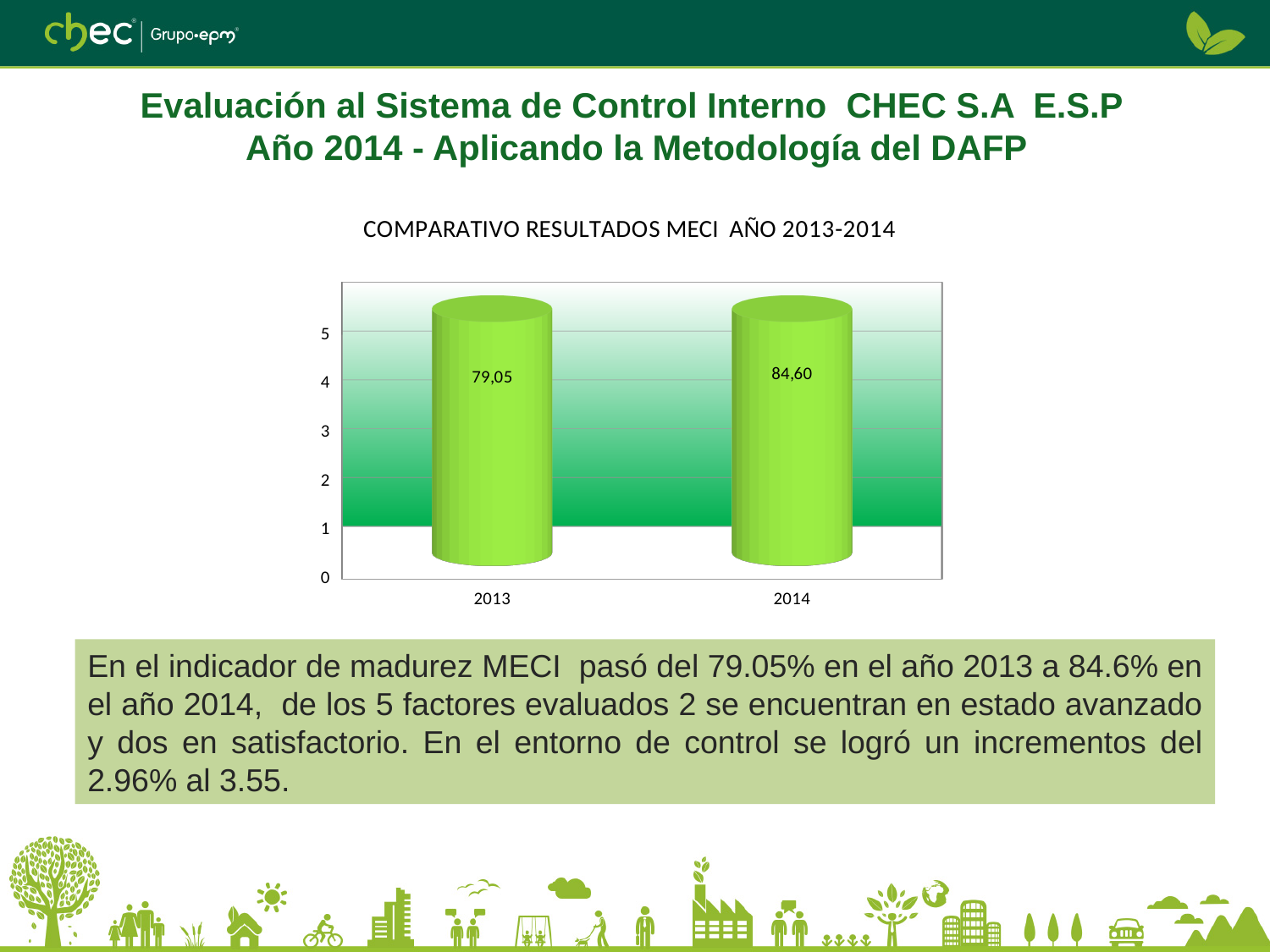
Do the labelled values rise or fall from 2013 to 2014? rise By how much does the labelled value for 2014 exceed the value for 2013? 5,55 Is the labelled value for 2014 larger or smaller than the value for 2013? larger Which year has the higher labelled value in the chart? 2014 What is the highest tick value shown on the chart's vertical axis? 5 What is the title of the chart on the slide? COMPARATIVO RESULTADOS MECI AÑO 2013-2014 What value is shown for 2014 in the COMPARATIVO RESULTADOS MECI chart? 84,60 What value is shown for 2013 in the COMPARATIVO RESULTADOS MECI chart? 79,05 What kind of chart is shown on the slide? bar chart How many years (categories) are plotted in the chart? 2 Which year has the lower labelled value in the chart? 2013